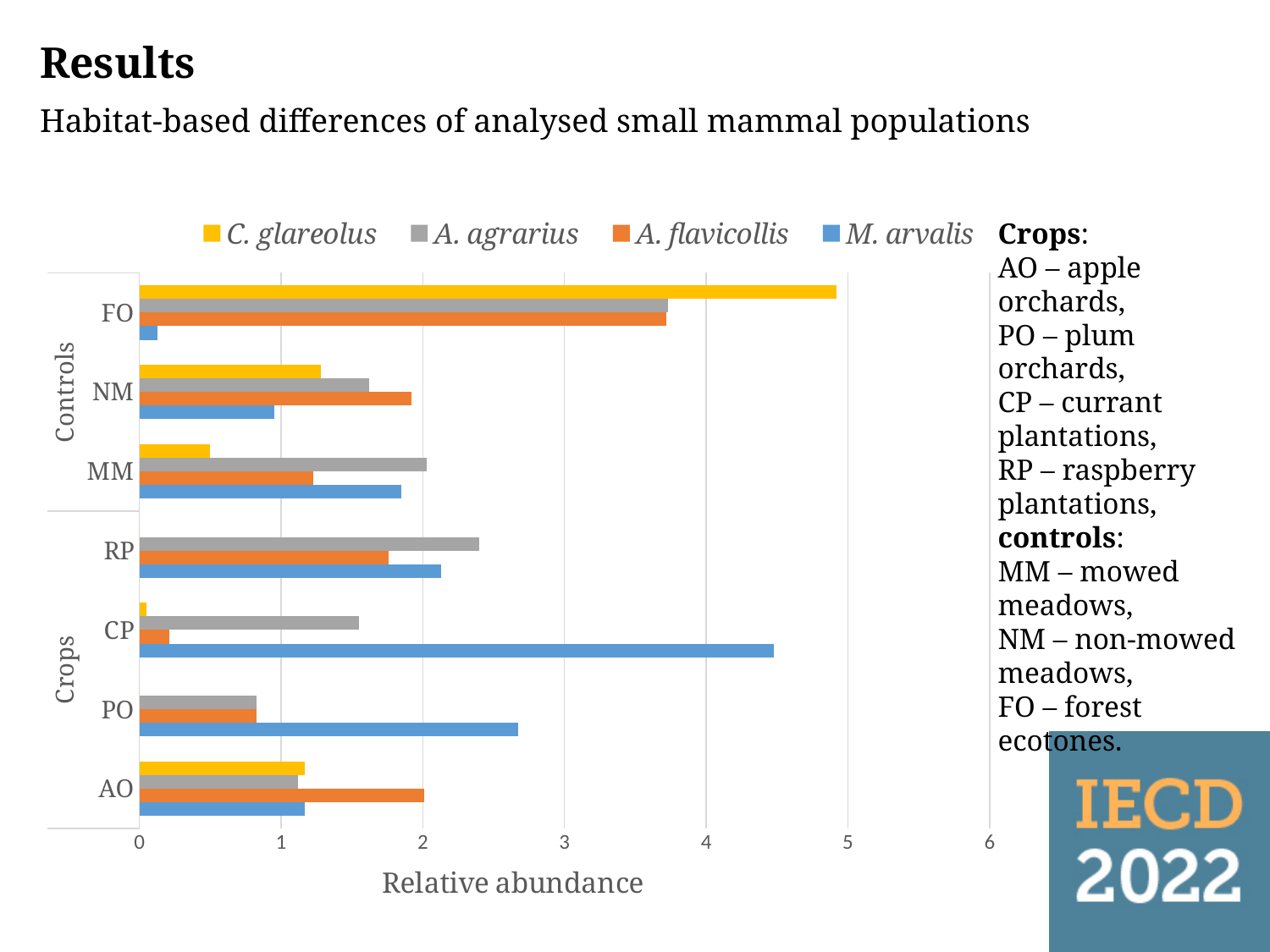
Is the relative abundance of M. arvalis in FO greater or less than 1? less Is the relative abundance of M. arvalis in CP greater or less than 4? greater Which species has the highest relative abundance in CP? M. arvalis What kind of chart is shown on the slide? bar chart Which habitat has the highest relative abundance of C. glareolus? FO Which habitat has the higher relative abundance of A. agrarius, RP or MM? RP Which species has the lowest relative abundance in FO? M. arvalis Is the relative abundance of C. glareolus in FO greater or less than 4? greater What is the title of the horizontal axis of the chart? Relative abundance Which habitat has the higher relative abundance of M. arvalis, CP or PO? CP How many species (series) does the chart legend list? 4 How many habitat categories are shown on the vertical axis of the chart? 7